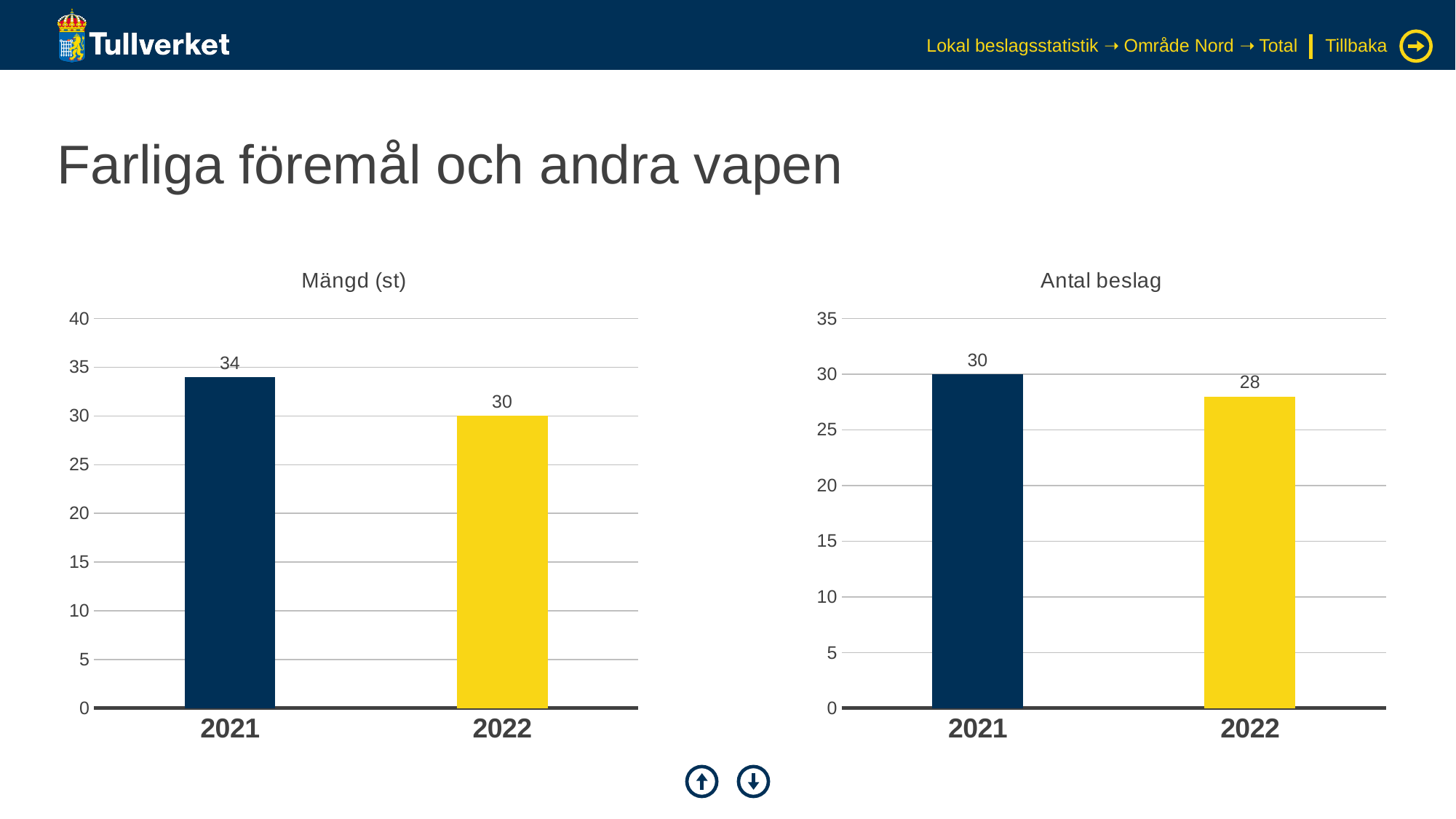
In the 'Antal beslag' chart, what is the difference between the 2021 and 2022 values? 2 In the 'Antal beslag' chart, which year has the lowest value? 2022 In the 'Mängd (st)' chart, what is the difference between the 2021 and 2022 values? 4 In the 'Antal beslag' chart, what is the value for 2022? 28 In the 'Antal beslag' chart, is the value for 2021 or 2022 larger? 2021 How many categories are shown in the 'Antal beslag' chart? 2 In the 'Mängd (st)' chart, which year has the highest value? 2021 In the 'Mängd (st)' chart, what is the value for 2021? 34 In the 'Mängd (st)' chart, what is the value for 2022? 30 In the 'Antal beslag' chart, what is the value for 2021? 30 What kind of chart is the 'Mängd (st)' chart? bar chart In the 'Mängd (st)' chart, do the values rise or fall from 2021 to 2022? fall